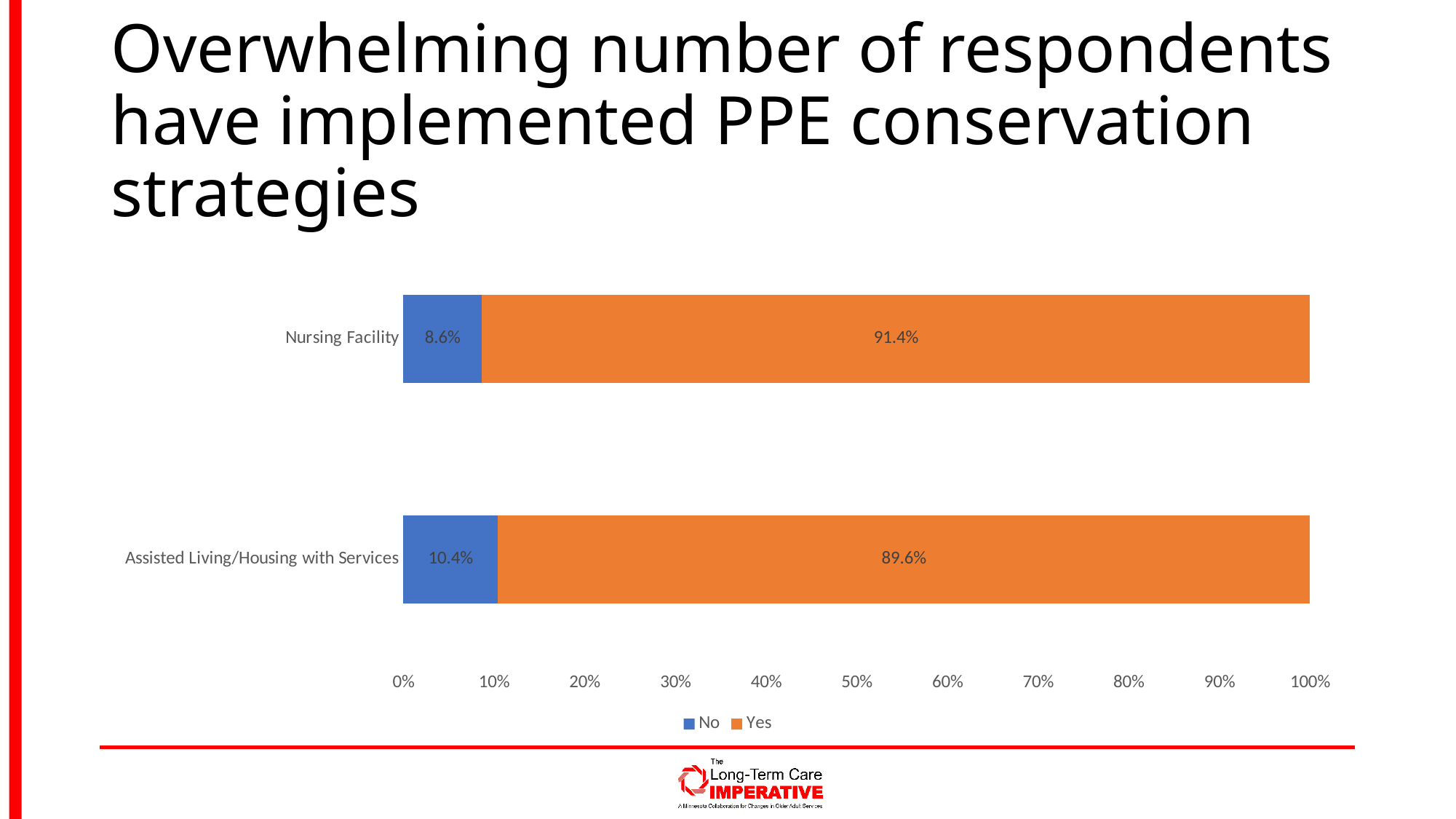
What percentage of Assisted Living/Housing with Services respondents answered Yes? 89.6% How many categories are shown on the chart? 2 What is the difference between the Yes percentages for Nursing Facility and Assisted Living/Housing with Services? 1.8% Is the No percentage for Assisted Living/Housing with Services larger or smaller than the No percentage for Nursing Facility? larger What percentage of Assisted Living/Housing with Services respondents answered No? 10.4% How many series does the legend list? 2 What kind of chart is shown on the slide? stacked bar chart Which category has the lower No percentage? Nursing Facility What percentage of Nursing Facility respondents answered Yes? 91.4% Which category has the higher Yes percentage? Nursing Facility What percentage of Nursing Facility respondents answered No? 8.6% Which colour represents the Yes series in the chart? orange